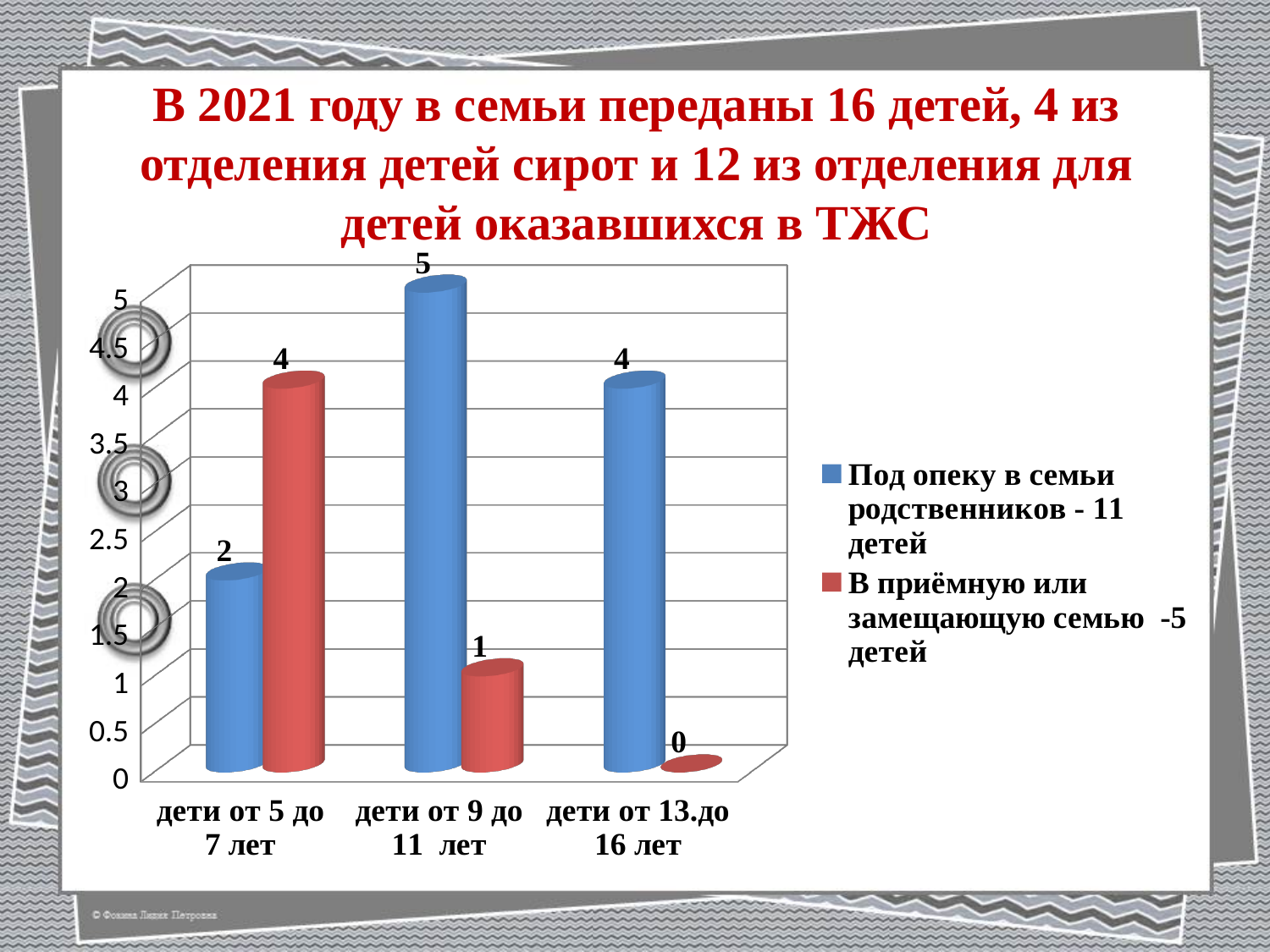
What is the total of the two series for 'дети от 13 до 16 лет'? 4 What colour are the bars for 'Под опеку в семьи родственников'? blue What is the difference between the two series for 'дети от 9 до 11 лет'? 4 How many series does the legend list? 2 Which age category has the lowest value for 'В приёмную или замещающую семью'? дети от 13 до 16 лет What is the value for 'В приёмную или замещающую семью' for 'дети от 5 до 7 лет'? 4 Which age category has the highest value for 'Под опеку в семьи родственников'? дети от 9 до 11 лет How many age categories are shown on the x axis? 3 What is the value for 'В приёмную или замещающую семью' for 'дети от 13 до 16 лет'? 0 What is the value for 'Под опеку в семьи родственников' for 'дети от 9 до 11 лет'? 5 For 'дети от 5 до 7 лет', which series has the larger value? В приёмную или замещающую семью What kind of chart is shown on the slide? bar chart